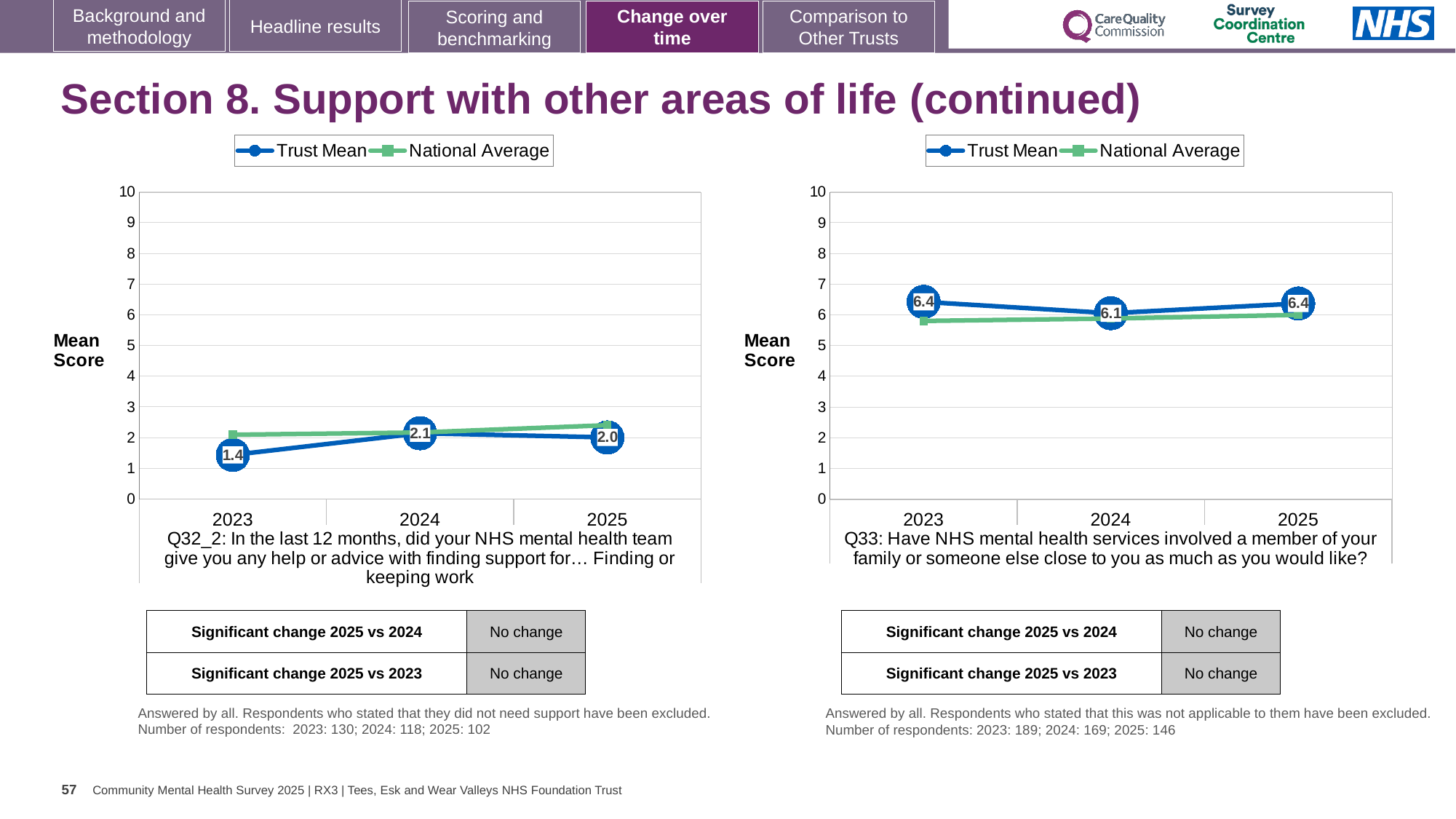
In the left chart (Q32_2), for 2023, which is higher: the Trust Mean or the National Average? National Average In the left chart (Q32_2), what is the Trust Mean for 2024? 2.1 In the right chart (Q33), what is the difference between the Trust Mean in 2025 and in 2024? 0.3 In the left chart (Q32_2), what is the difference between the Trust Mean in 2024 and in 2023? 0.7 In the left chart (Q32_2), what is the Trust Mean for 2023? 1.4 How many series does the legend of the right chart (Q33) list? 2 In the right chart (Q33), is the National Average value for 2023 greater or less than 7? less In the right chart (Q33), what is the Trust Mean for 2025? 6.4 In the left chart (Q32_2), which year has the lowest Trust Mean? 2023 What kind of chart is the left chart (Q32_2)? Line chart In the right chart (Q33), what is the Trust Mean for 2024? 6.1 In the right chart (Q33), which year has the lowest Trust Mean? 2024